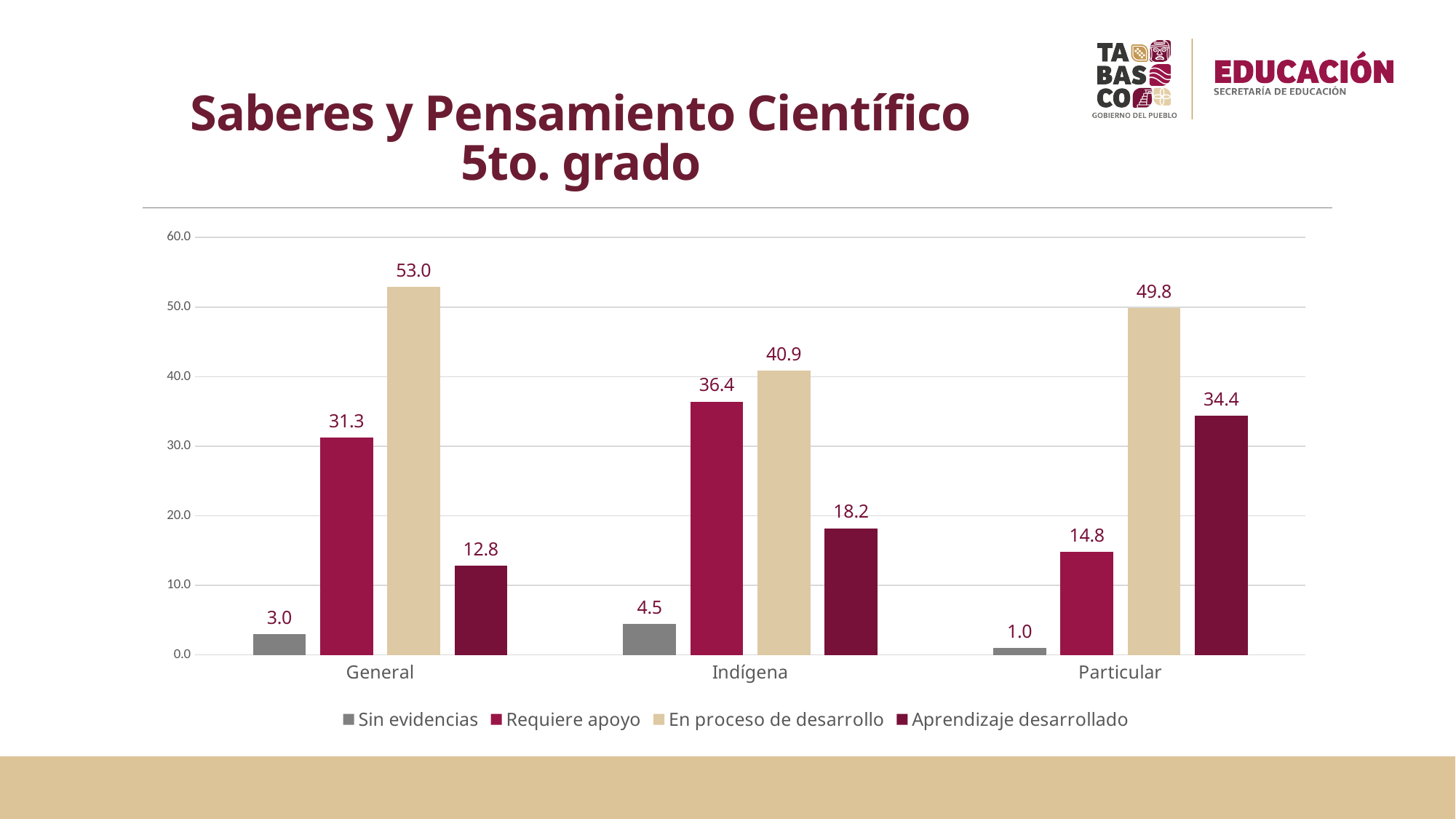
What kind of chart is shown on the slide? Bar chart Which category has the lowest value for "Requiere apoyo"? Particular What is the difference between the "En proceso de desarrollo" values for General and Indígena? 12.1 What is the title of the slide? Saberes y Pensamiento Científico 5to. grado What is the value for "Requiere apoyo" in the Indígena category? 36.4 What is the value for "Sin evidencias" in the Particular category? 1.0 What is the value for "Aprendizaje desarrollado" in the Indígena category? 18.2 Which is larger: "Requiere apoyo" for General or "Requiere apoyo" for Indígena? Indígena How many series does the legend list? 4 Which category has the highest value for "Aprendizaje desarrollado"? Particular How many categories are shown on the x axis? 3 What is the value for "En proceso de desarrollo" in the General category? 53.0